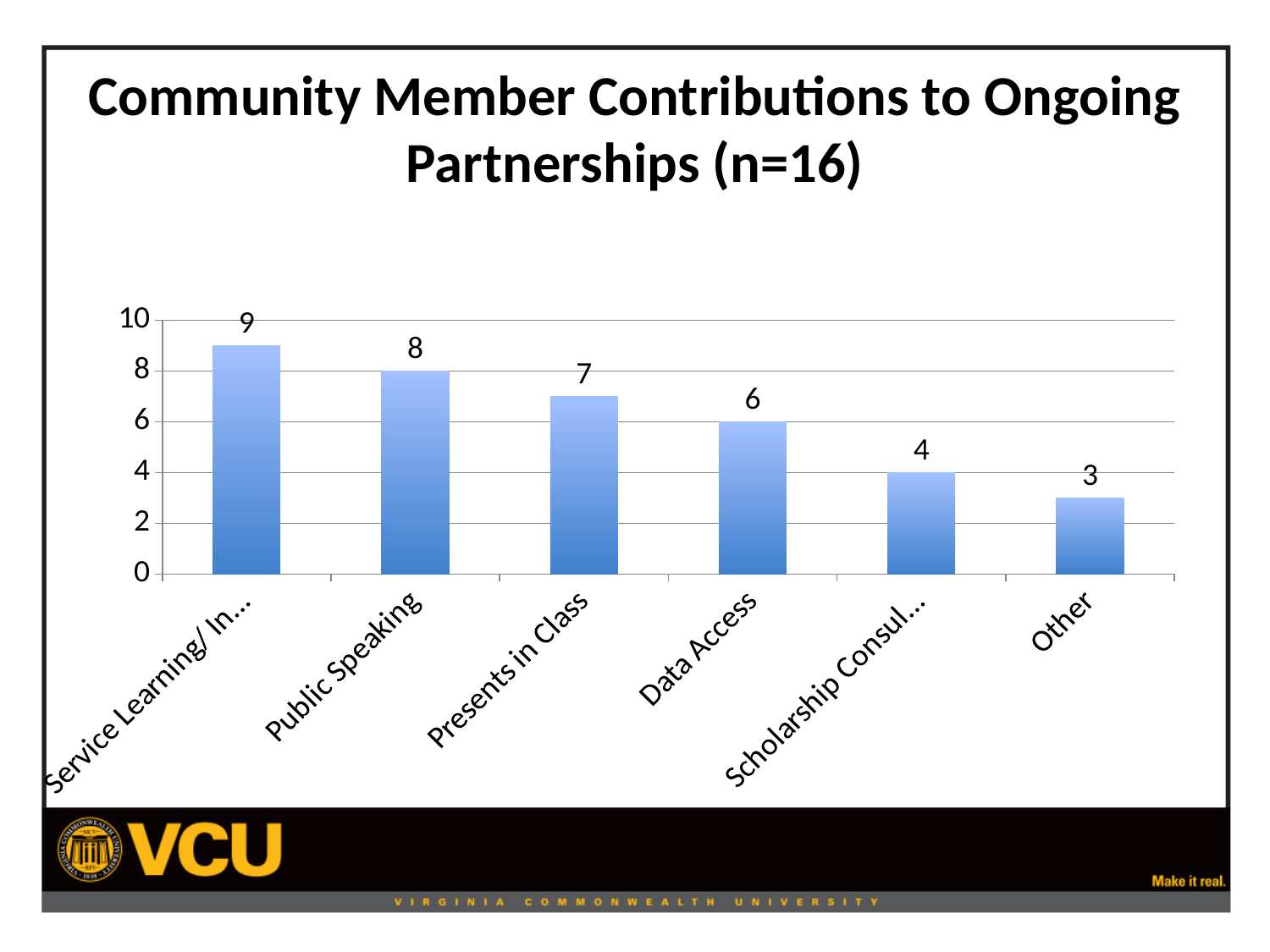
What is the difference between the values for Presents in Class and Other? 4 What is the value of the leftmost bar? 9 What is the difference between the values for Public Speaking and Data Access? 2 Which category has the lowest value? Other What is the value for Public Speaking? 8 Which is larger, the value for Public Speaking or the value for Presents in Class? Public Speaking What is the value for Data Access? 6 What kind of chart is shown on the slide? Bar chart How many categories are shown in the chart? 6 What is the value for Presents in Class? 7 Do the values rise or fall from left to right across the categories? Fall What is the value for Other? 3